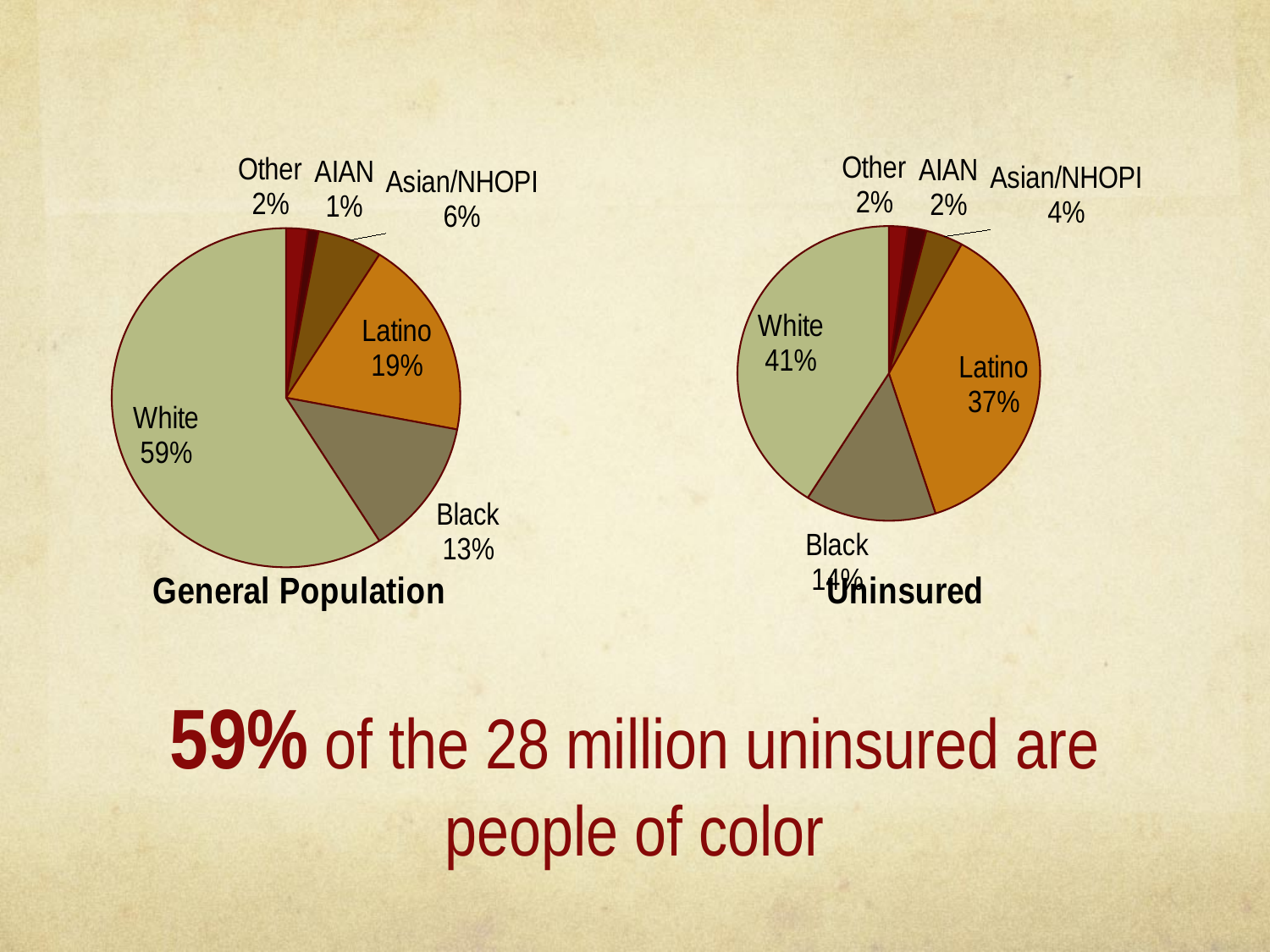
In the General Population pie chart, which group has the smallest share? AIAN What type of chart is used for the Uninsured data? Pie chart What is the title of the pie chart on the left? General Population In the General Population pie chart, what share is Black? 13% Is the Latino share larger in the General Population chart or in the Uninsured chart? Uninsured In the General Population pie chart, what share is White? 59% How many slices does the General Population pie chart have? 6 In the Uninsured pie chart, what share is Latino? 37% In the Uninsured pie chart, which group has the largest share? White In the General Population pie chart, which group has the largest share? White In the Uninsured pie chart, what share is Asian/NHOPI? 4% What is the difference between the White share in the General Population chart and the White share in the Uninsured chart? 18 percentage points